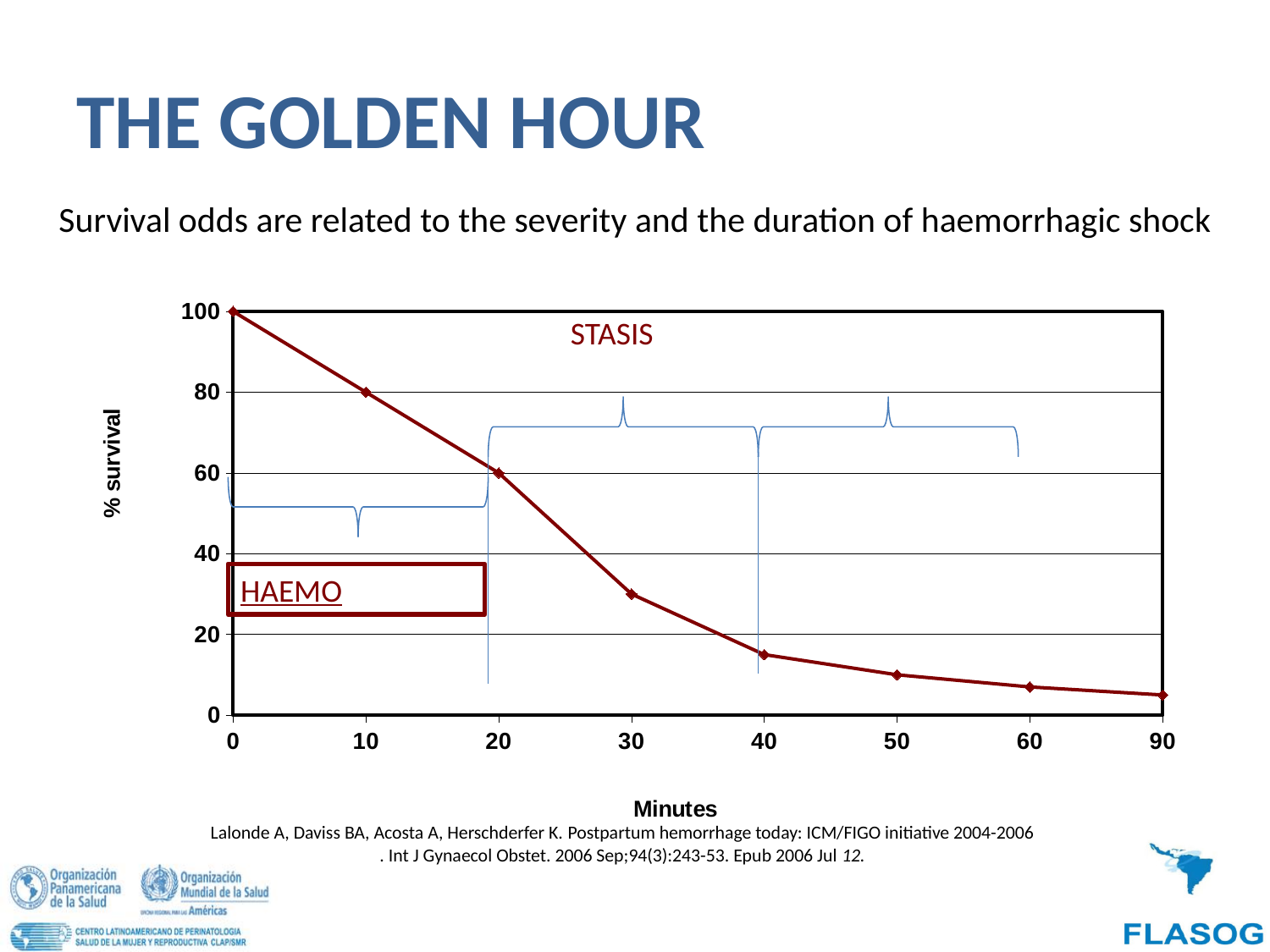
What kind of chart is shown on the slide? line chart What is the % survival at 10 minutes? 80 What is the % survival at 0 minutes? 100 Does % survival rise or fall as minutes increase? fall At which number of minutes is % survival highest? 0 Is the % survival at 40 minutes greater or less than 20? less How many data points are plotted on the line? 8 What is the difference in % survival between 0 minutes and 20 minutes? 40 Which has a higher % survival, 10 minutes or 30 minutes? 10 minutes At which number of minutes is % survival lowest? 90 Is the % survival at 30 minutes greater or less than 40? less What is the % survival at 20 minutes? 60